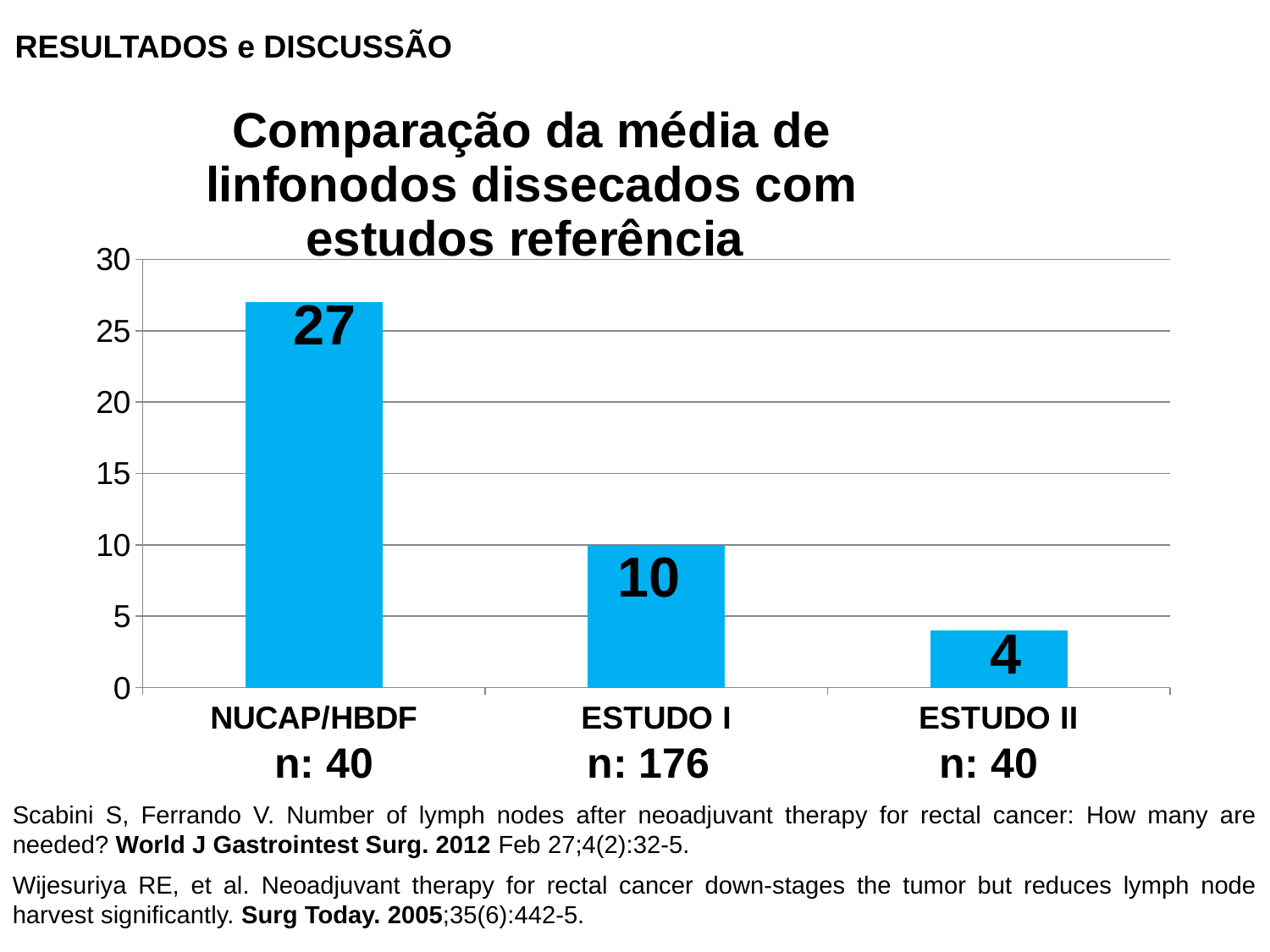
How many categories are shown on the x axis? 3 What is the difference between the values for NUCAP/HBDF and ESTUDO I? 17 What is the value for NUCAP/HBDF? 27 What is the difference between the values for ESTUDO I and ESTUDO II? 6 Is the value for NUCAP/HBDF greater or less than 25? greater What kind of chart is shown on the slide? bar chart Which category has the highest value? NUCAP/HBDF What is the value for ESTUDO II? 4 Which category has the lowest value? ESTUDO II What is the value for ESTUDO I? 10 Do the values rise or fall from left to right along the x axis? fall Which is larger, the value for ESTUDO I or the value for ESTUDO II? ESTUDO I